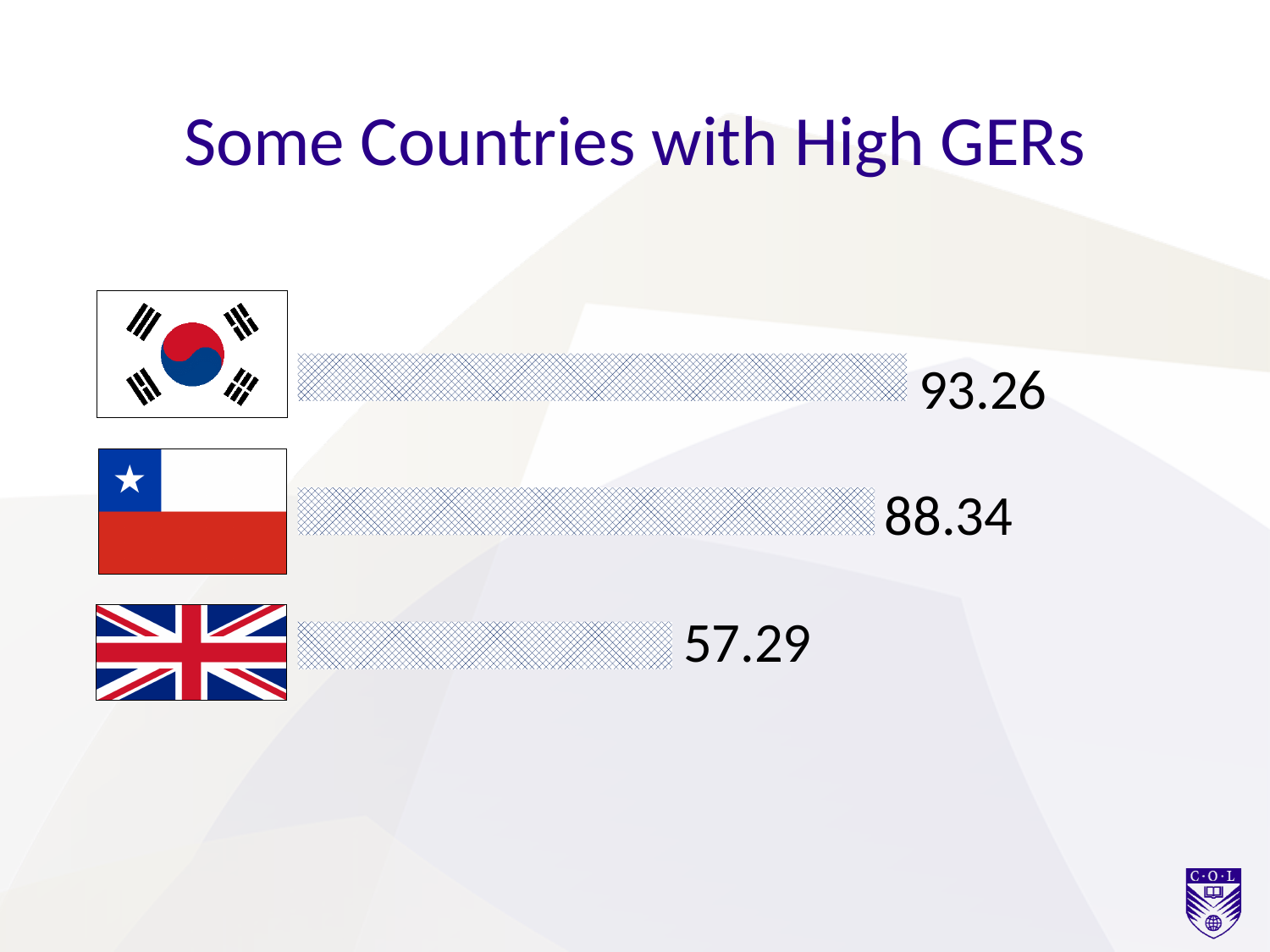
What is the difference between the values for South Korea and Chile? 4.92 Which country has the highest value on the chart? South Korea What value is shown for the bottom bar (United Kingdom flag)? 57.29 Which country has the lowest value on the chart? United Kingdom What value is shown for the top bar (South Korea flag)? 93.26 What kind of chart is shown on the slide? Bar chart What is the difference between the values for Chile and the United Kingdom? 31.05 Which is larger, the value for Chile or the value for the United Kingdom? Chile How are the categories labelled on the chart? With national flags What value is shown for the middle bar (Chile flag)? 88.34 What is the title of the slide? Some Countries with High GERs How many countries are shown on the chart? 3